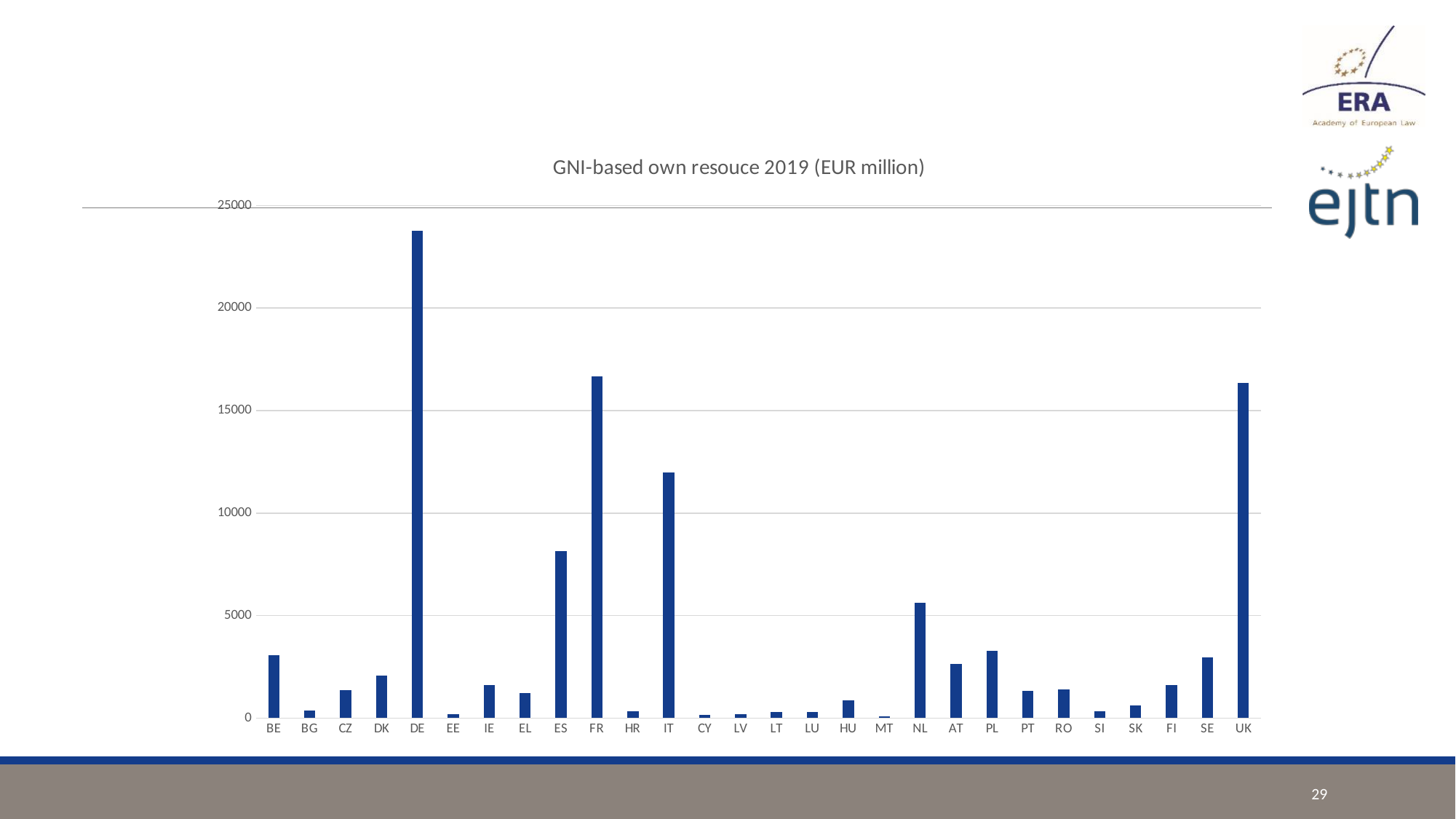
Is the value for DE greater or less than 20000? greater What is the title of the chart? GNI-based own resouce 2019 (EUR million) How many countries are shown on the x axis of the chart? 28 Which country has the highest GNI-based own resource in the chart? DE Is the value for IT greater or less than 10000? greater Which has a larger value, NL or AT? NL Is the value for ES greater or less than 10000? less What kind of chart is shown on the slide? bar chart Which has a larger value, IT or ES? IT